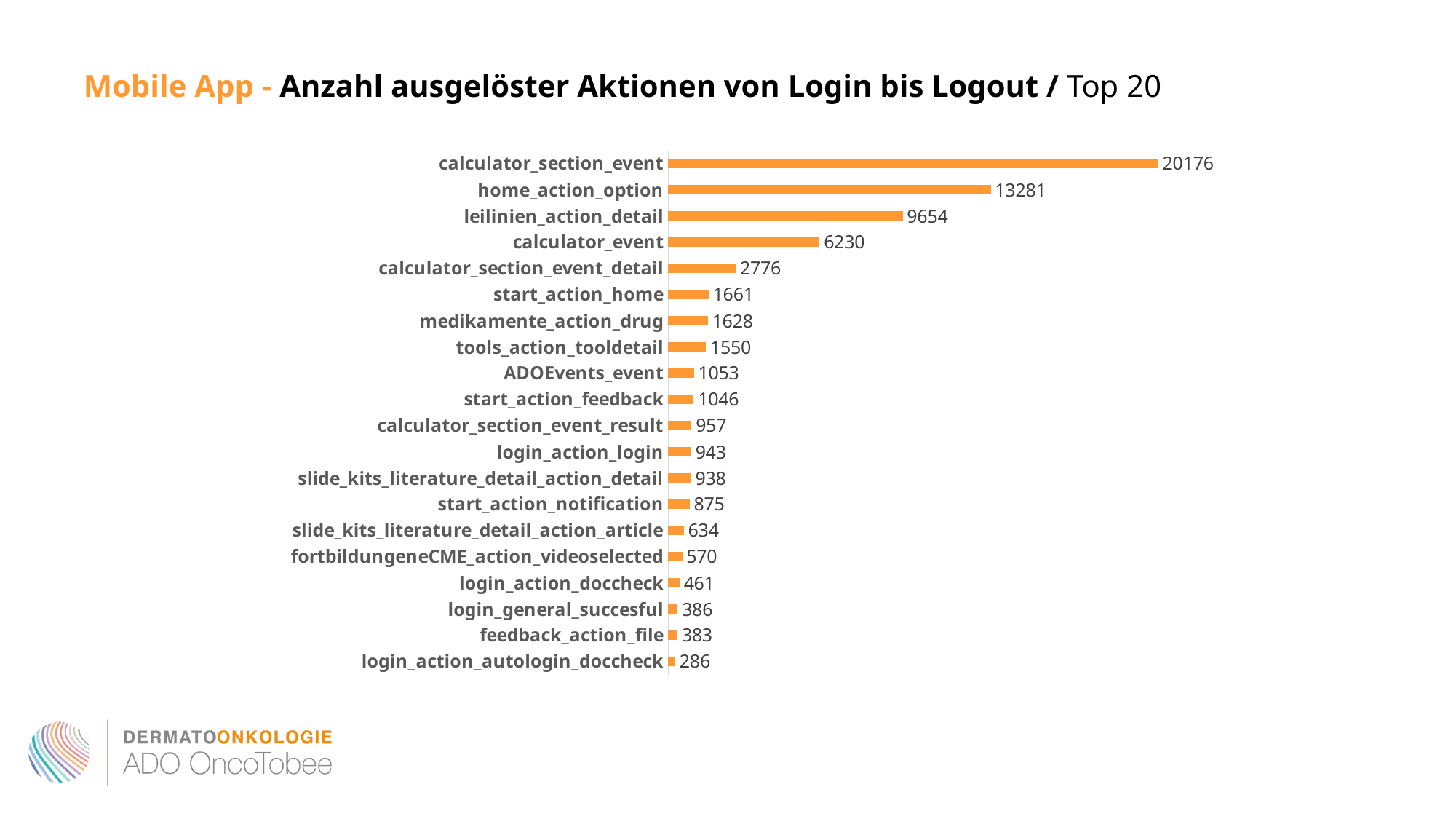
What is the difference between calculator_event and calculator_section_event_detail? 3454 What kind of chart is shown on the slide? bar chart What is the value for login_action_doccheck? 461 What is the value for medikamente_action_drug? 1628 What colour are the bars in the chart? orange What is the difference between home_action_option and leilinien_action_detail? 3627 Which is larger, start_action_home or tools_action_tooldetail? start_action_home Which is larger, fortbildungeneCME_action_videoselected or slide_kits_literature_detail_action_article? slide_kits_literature_detail_action_article Which category has the highest value? calculator_section_event Which category has the lowest value? login_action_autologin_doccheck What is the value for calculator_section_event? 20176 How many categories are shown in the chart? 20